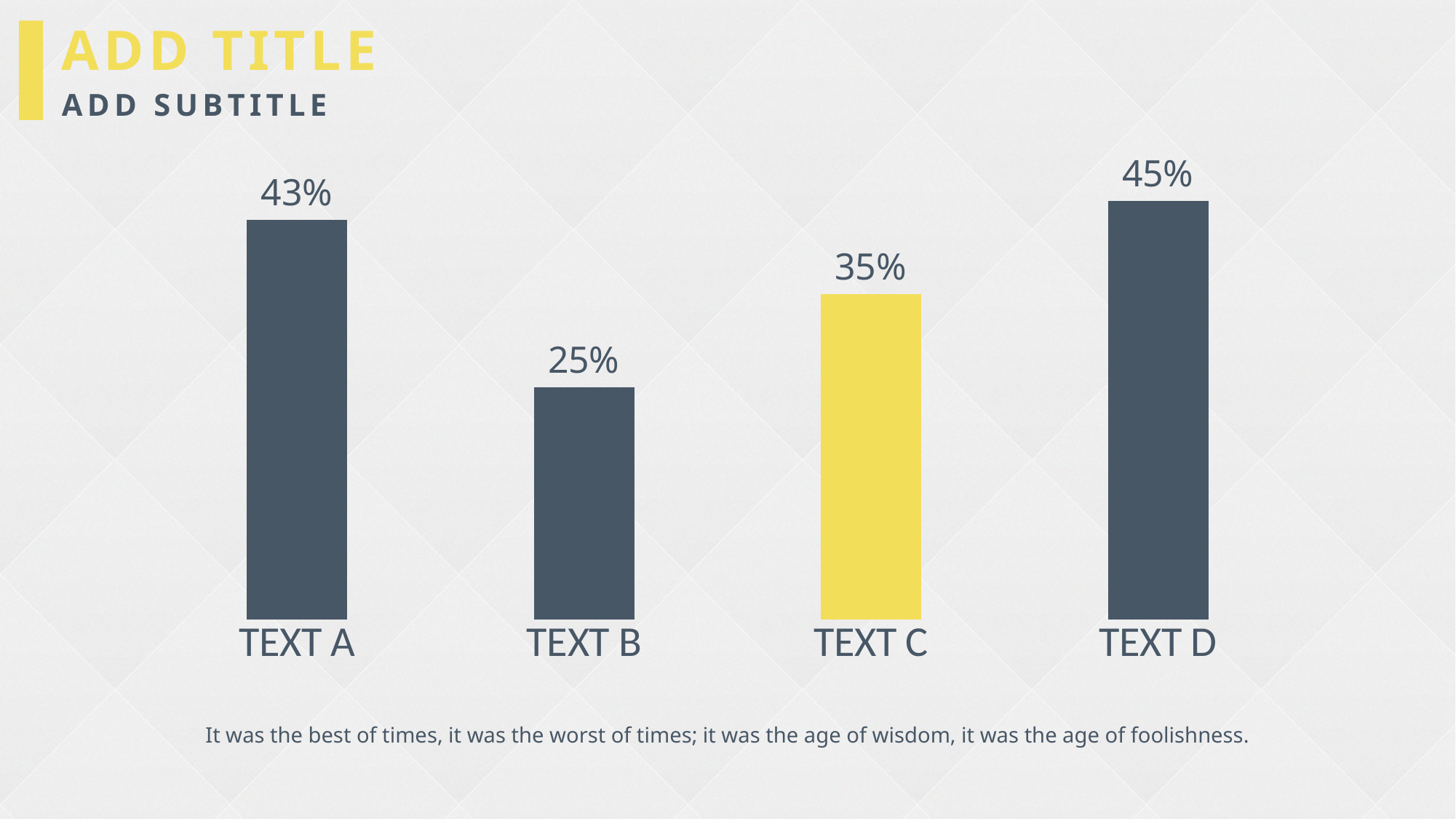
What is the difference between the values for TEXT D and TEXT B? 20% Which bar is coloured yellow rather than dark grey? TEXT C What kind of chart is shown on the slide? bar chart What is the value for TEXT C? 35% Which category has the lowest value? TEXT B What is the value for TEXT D? 45% What is the difference between the values for TEXT A and TEXT C? 8% What is the value for TEXT B? 25% Which category has the highest value? TEXT D Which is larger, the value for TEXT A or the value for TEXT C? TEXT A What is the value for TEXT A? 43% How many bars are shown in the chart? 4